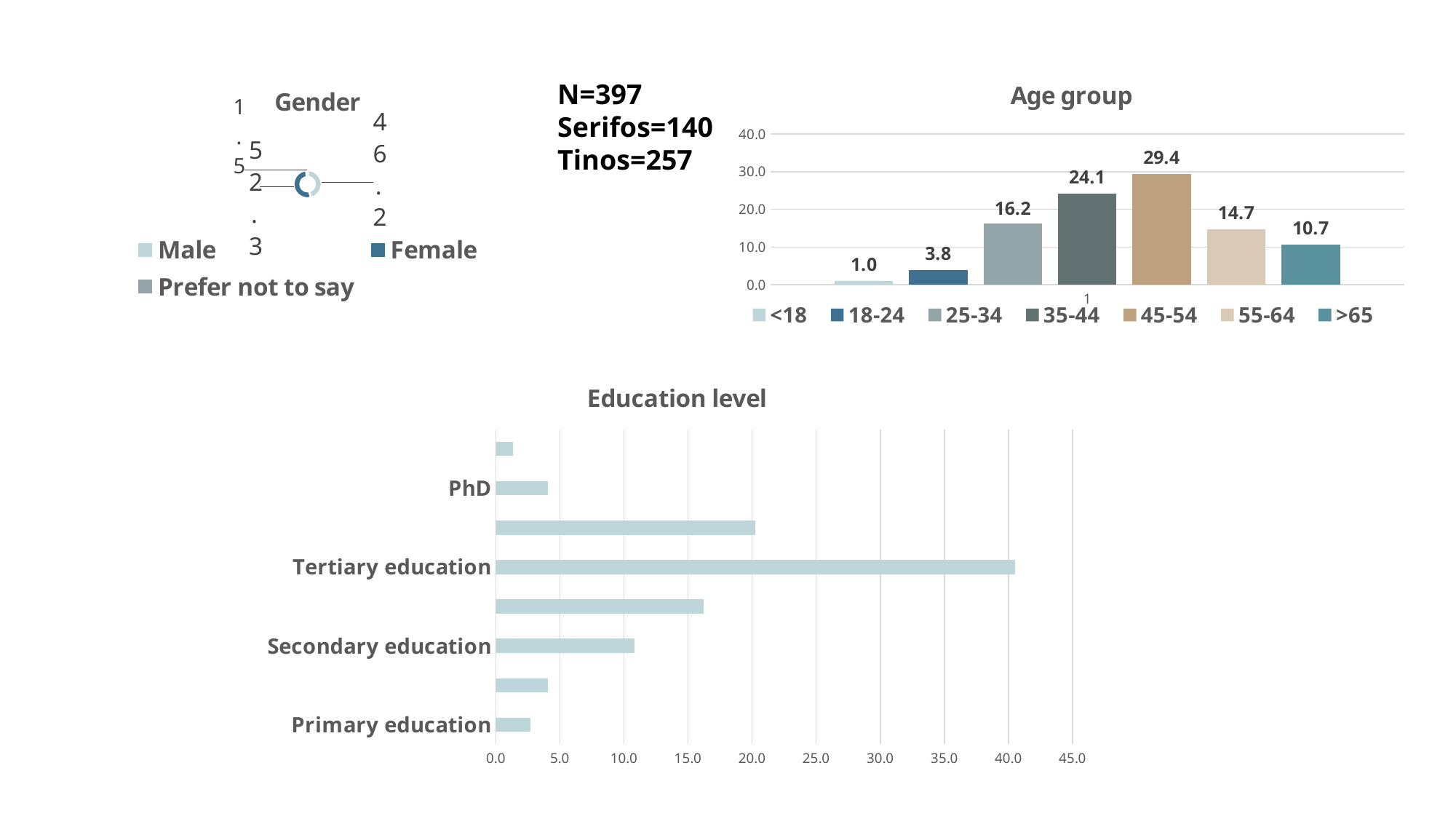
What kind of chart is the Education level chart? Bar chart In the Age group chart, what is the value for the 45-54 age group? 29.4 In the Age group chart, what is the value for the >65 age group? 10.7 In the Age group chart, which age group has the highest value? 45-54 How many bars are plotted in the Education level chart? 8 In the Age group chart, what is the difference between the values for 35-44 and 25-34? 7.9 How many age groups are shown in the Age group chart? 7 In the Age group chart, which is larger, the value for 55-64 or the value for >65? 55-64 How many entries does the legend of the Gender chart list? 3 In the Education level chart, is the longest bar greater or less than 35.0? greater In the Age group chart, which age group has the lowest value? <18 In the Age group chart, what is the value for the 18-24 age group? 3.8